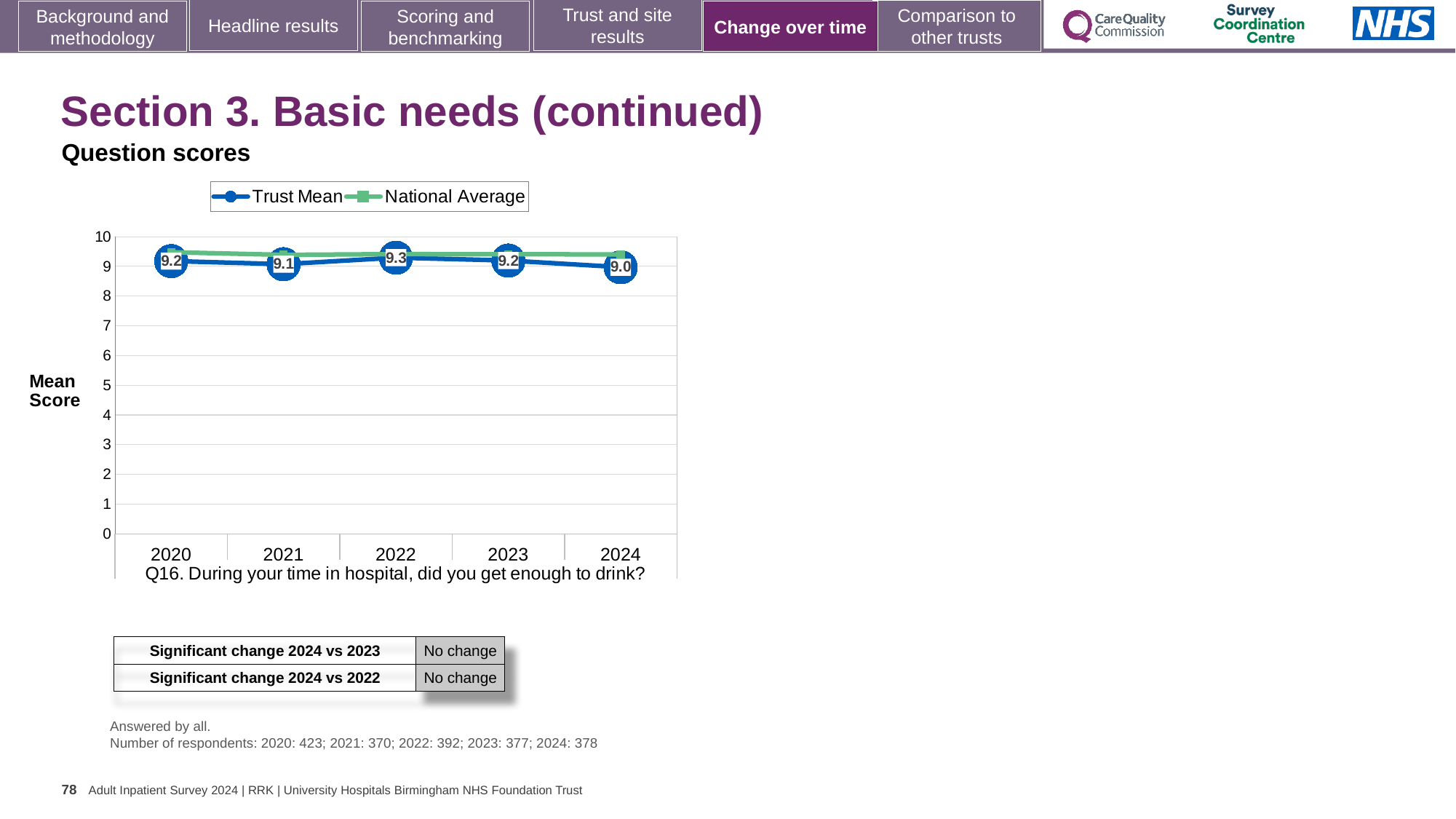
What is the Trust Mean score for 2020? 9.2 In which year is the Trust Mean highest? 2022 What is the Trust Mean score for 2022? 9.3 Which is larger, the Trust Mean in 2021 or in 2023? 2023 What is the Trust Mean score for 2024? 9.0 What is the difference between the Trust Mean in 2022 and in 2024? 0.3 How many years are plotted on the x axis? 5 How many series does the legend list? 2 In which year is the Trust Mean lowest? 2024 Does the Trust Mean rise or fall from 2023 to 2024? Fall What kind of chart is shown? Line chart Is the National Average value for 2024 greater or less than 9? greater